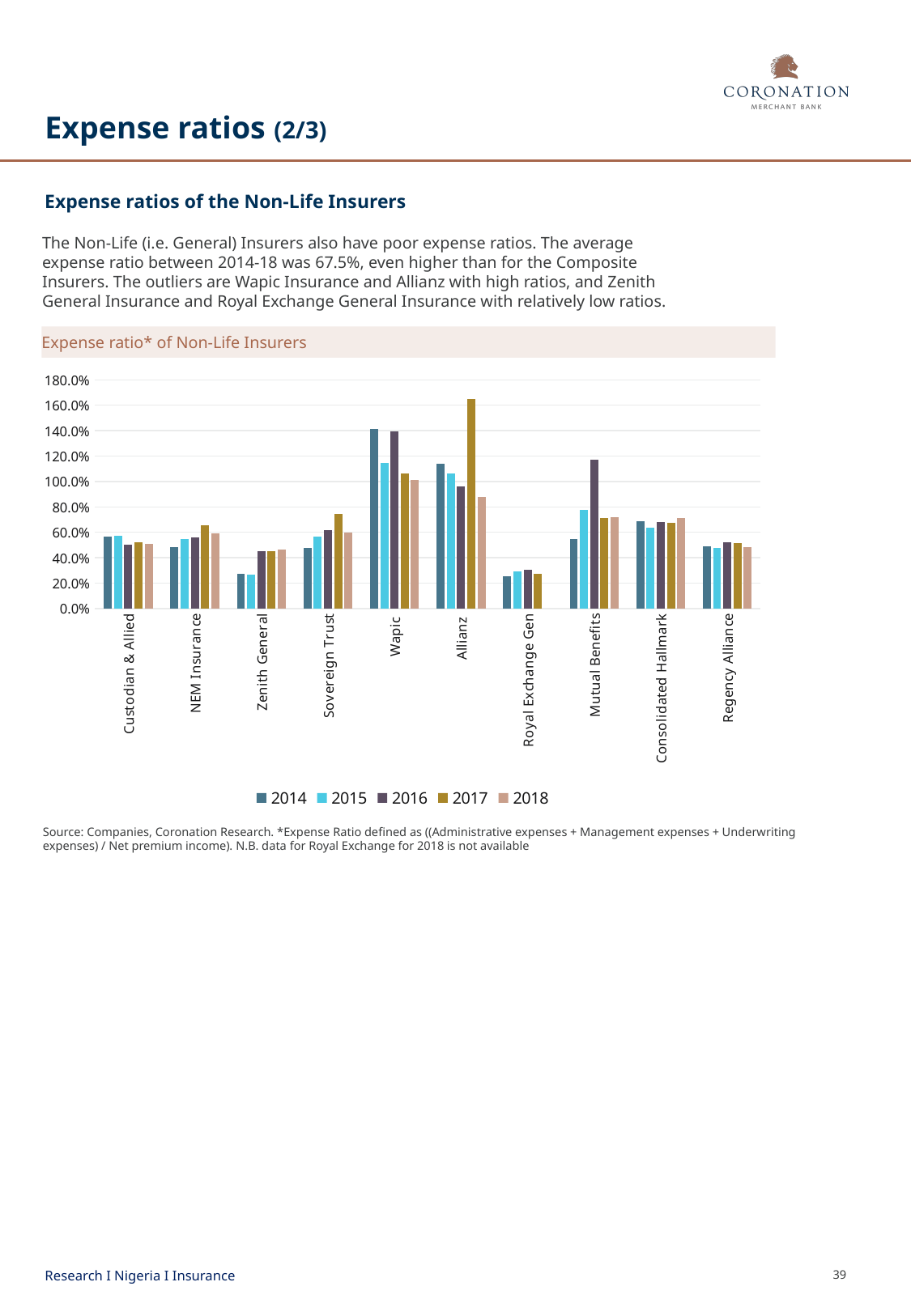
Which insurer has the lowest 2017 expense ratio in the chart? Royal Exchange Gen How many insurers (categories) are shown on the x axis of the chart? 10 Which is larger, the 2014 expense ratio for Wapic or the 2014 expense ratio for Allianz? Wapic Which is larger, the 2015 expense ratio for Mutual Benefits or the 2015 expense ratio for Custodian & Allied? Mutual Benefits Is the 2017 expense ratio for Allianz greater or less than 160.0%? greater Is the 2014 expense ratio for Zenith General greater or less than 40.0%? less How many series does the chart legend list? 5 What is the title of the chart on the slide? Expense ratio* of Non-Life Insurers Is the 2016 expense ratio for Mutual Benefits greater or less than 100.0%? greater Which insurer has the highest 2017 expense ratio in the chart? Allianz What kind of chart is shown on the slide? Bar chart Which insurer has the highest 2014 expense ratio in the chart? Wapic